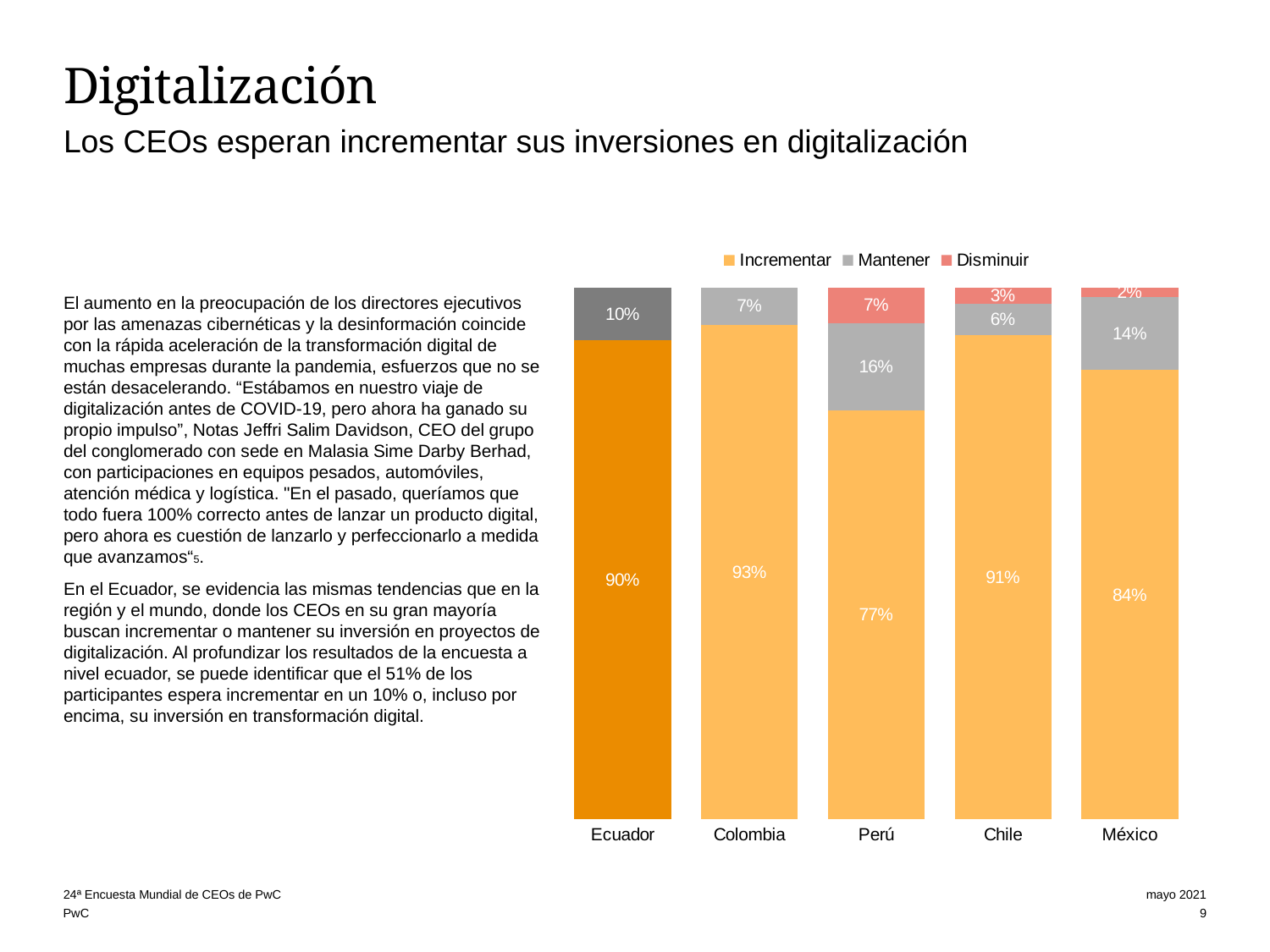
What are the three series named in the chart legend? Incrementar, Mantener, Disminuir What is the difference between the Incrementar values for Colombia and Perú? 16 percentage points What is the Incrementar value for Ecuador? 90% What percentage of CEOs in Perú expect to increase (Incrementar) their digitalization investment? 77% Which has a larger Mantener value, Perú or México? Perú How many countries are shown on the x axis of the chart? 5 What is the Disminuir value for Chile? 3% What kind of chart is shown on the slide? Stacked bar chart How many series does the chart legend list? 3 Which country has the lowest Incrementar value? Perú What is the Mantener value for México? 14% Which country has the highest Incrementar value? Colombia